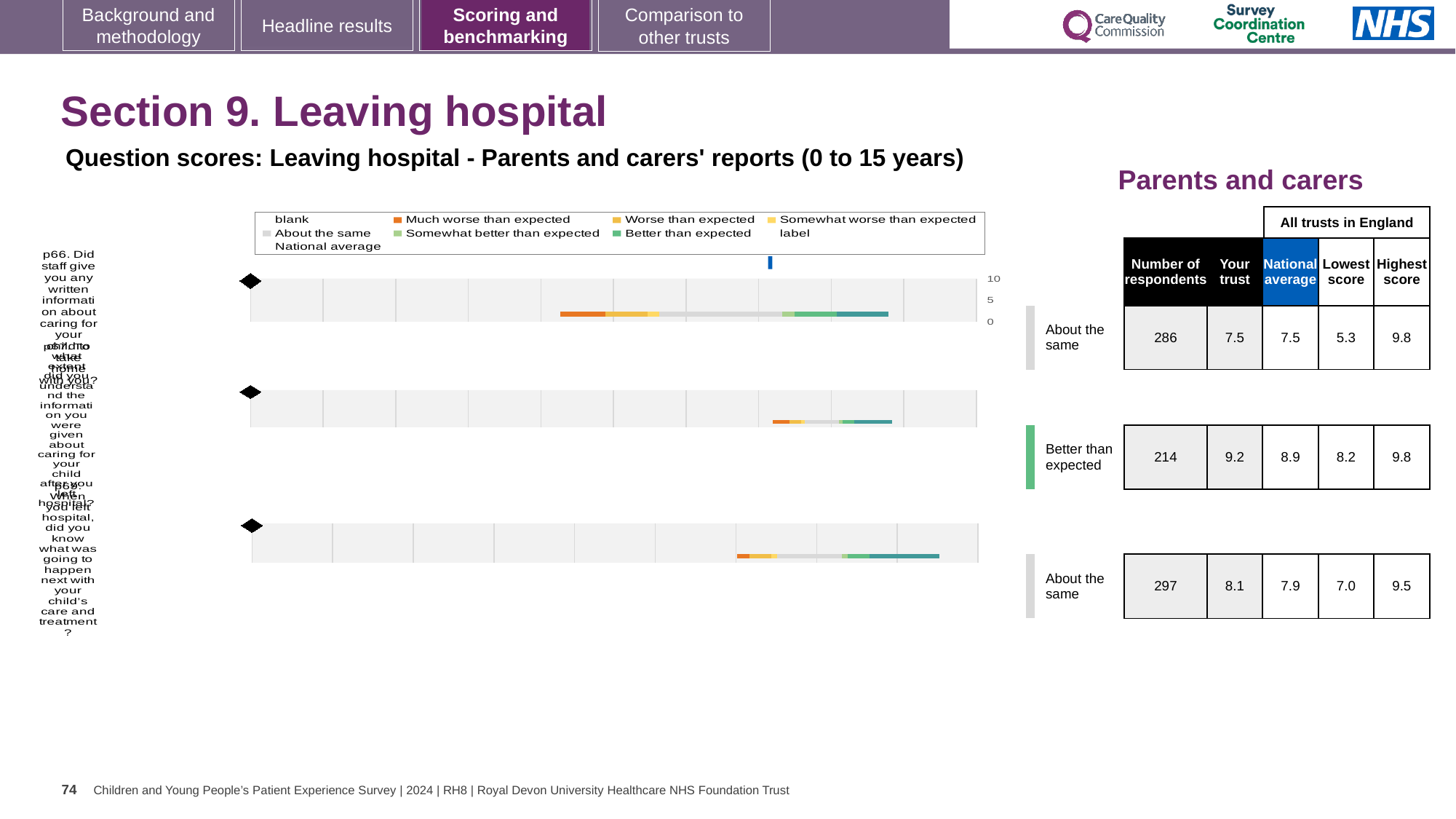
How many entries does the legend above the charts list? 9 For the second row (214 respondents), which is larger: the 'Your trust' score or the national average? Your trust Which row in the table has the highest 'Your trust' score? Better than expected (9.2) In the table, how many respondents are recorded for the second row (Better than expected)? 214 What colour does the legend use for 'Much worse than expected'? orange In the table, what is the highest score for the third row (297 respondents)? 9.5 In the table, what is the lowest score for the second row (Better than expected)? 8.2 For the second row (214 respondents), what is the difference between the 'Your trust' score and the national average? 0.3 What kind of chart is used to show the question scores on this slide? bar chart How many question bars (rows) are plotted on the slide? 3 In the table, what is the 'Your trust' score for the first row (286 respondents)? 7.5 What is the subtitle above the charts describing the question scores? Question scores: Leaving hospital - Parents and carers' reports (0 to 15 years)